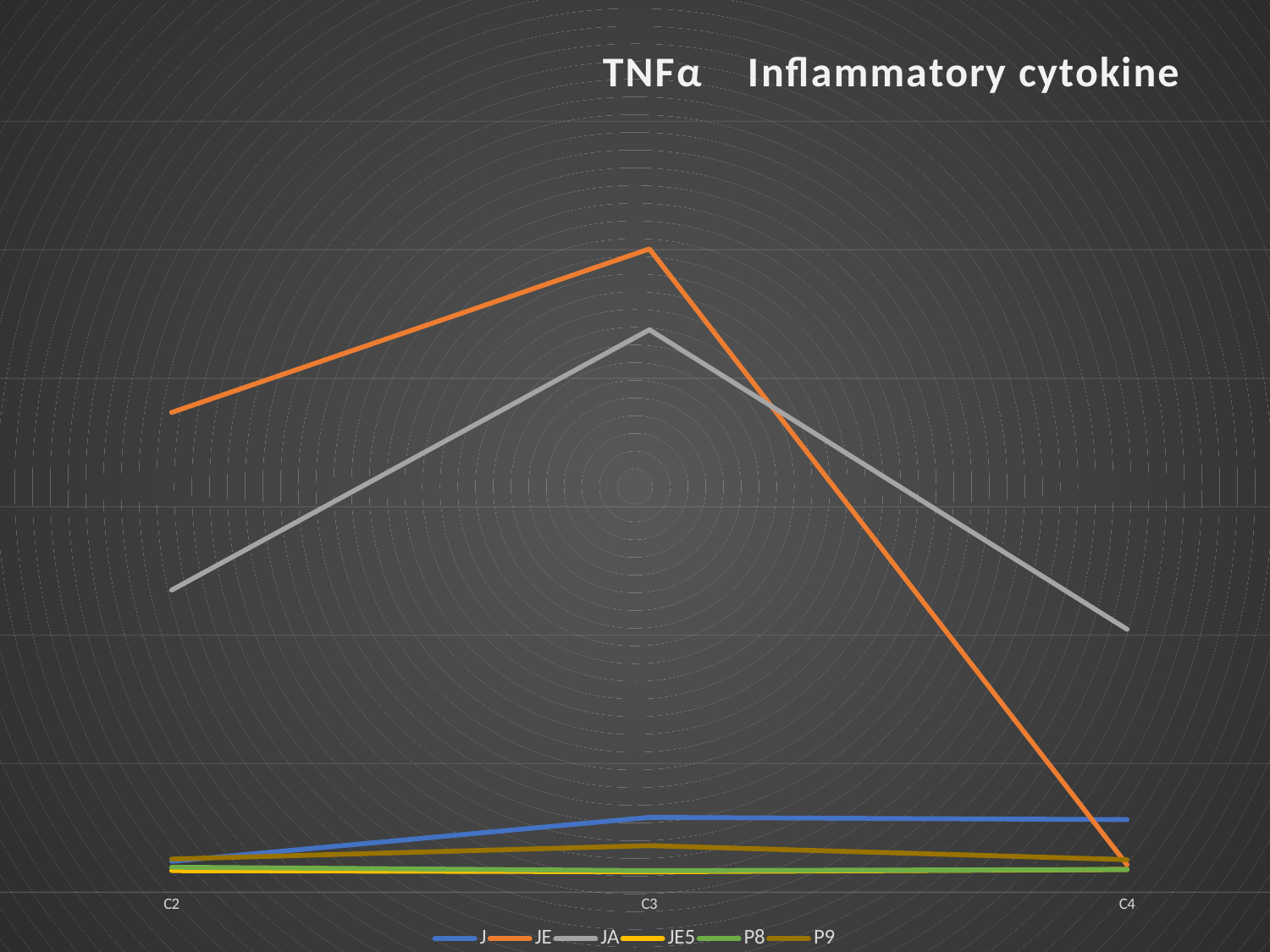
How many categories are shown on the x axis? 3 Does the JE series rise or fall from C3 to C4? fall For the JA series, which is larger, the value at C2 or the value at C3? C3 Which series has the highest value at C2? JE At C3, which is larger, the value for J or the value for P9? J What is the title of the chart? TNFα Inflammatory cytokine At C2, which is larger, the value for JE or the value for JA? JE What kind of chart is shown on the slide? line chart Which series has the highest value at C4? JA What colour is the line for the JE series? orange Which series has the highest value at C3? JE How many series does the legend list? 6